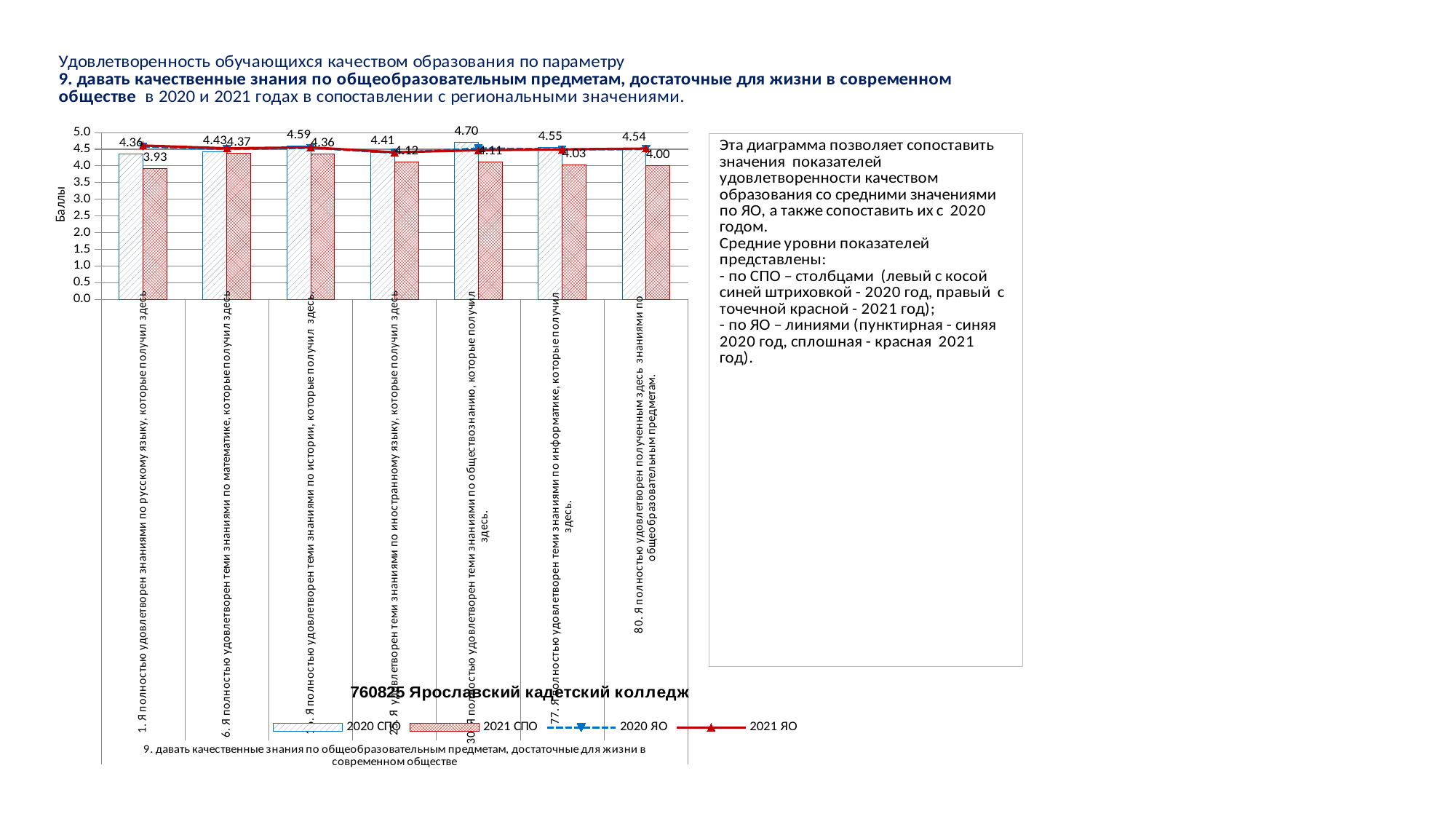
What is the 2021 СПО value for the last category, about general education subjects (общеобразовательным предметам)? 4.00 What is the difference between the 2020 СПО and 2021 СПО values for the social studies (обществознанию) category? 0.59 What is the difference between the 2020 СПО and 2021 СПО values for the Russian language category? 0.43 Which category has the highest 2020 СПО value? 30. Я полностью удовлетворен теми знаниями по обществознанию, которые получил здесь (4.70) How many categories are shown on the x axis of the chart? 7 What is the 2021 СПО value for the category about knowledge of mathematics (математике)? 4.37 For the informatics (информатике) category, which is larger: the 2020 СПО value or the 2021 СПО value? 2020 СПО (4.55 vs 4.03) What is the 2020 СПО value for the category about knowledge of Russian language (русскому языку)? 4.36 What is the title of the vertical axis of the chart? Баллы Which category has the lowest 2021 СПО value? 1. Я полностью удовлетворен знаниями по русскому языку, которые получил здесь (3.93) How many series does the chart legend list? 4 What is the 2020 СПО value for the category about knowledge of history (истории)? 4.59